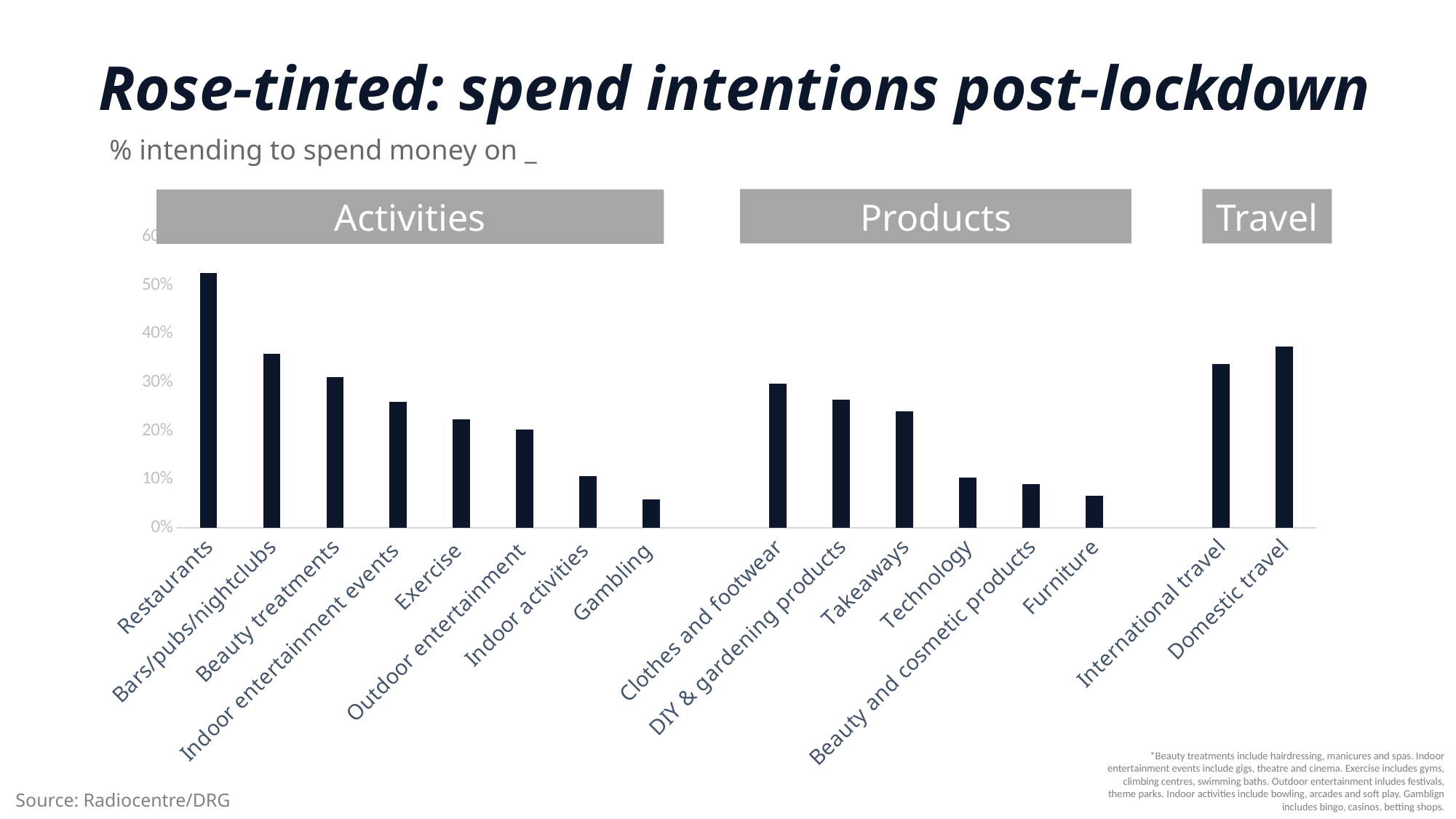
Is the value for Technology greater or less than 20%? less Is the value for Bars/pubs/nightclubs greater or less than 30%? greater Which is larger, the value for Takeaways or Technology? Takeaways What is the source cited for the chart? Radiocentre/DRG How many categories are plotted in the chart? 16 Is the value for Domestic travel greater or less than 30%? greater What kind of chart is shown on the slide? bar chart What are the three group headings shown above the bars? Activities, Products, Travel Which category has the highest value in the chart? Restaurants Which is larger, the value for Domestic travel or International travel? Domestic travel